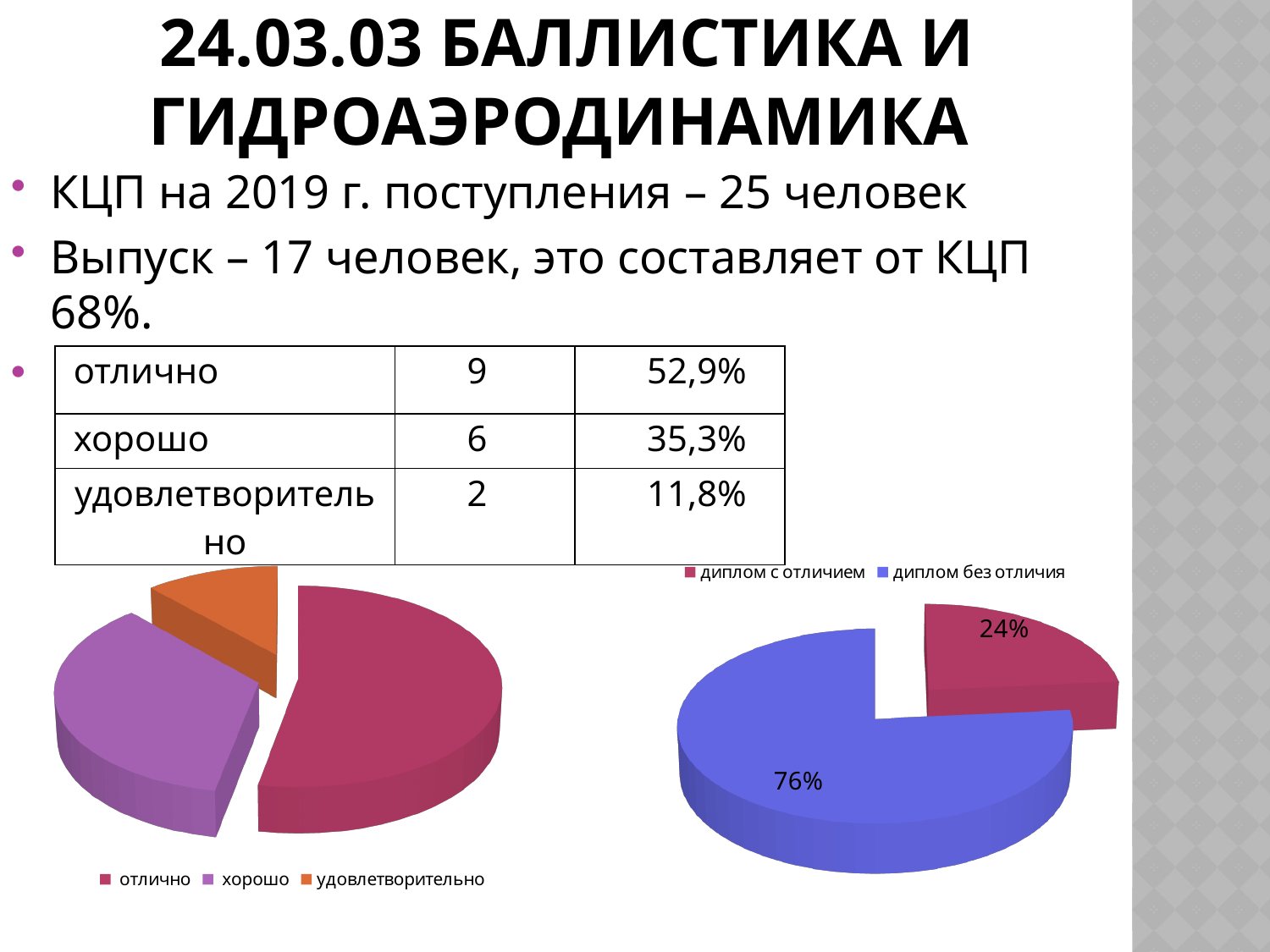
In the right pie chart, what is the difference between the shares of 'диплом без отличия' and 'диплом с отличием'? 52% What kind of chart is the chart on the left of the slide? pie chart In the left pie chart, which colour represents 'хорошо'? purple In the left pie chart, which slice is the smallest? удовлетворительно In the right pie chart, what share does the slice 'диплом без отличия' have? 76% How many slices does the right pie chart have? 2 What kind of chart is the chart on the right of the slide? pie chart In the right pie chart, which slice is the largest? диплом без отличия How many slices does the left pie chart have? 3 In the right pie chart, which slice is the smallest? диплом с отличием In the right pie chart, what share does the slice 'диплом с отличием' have? 24% In the left pie chart, which slice is the largest? отлично